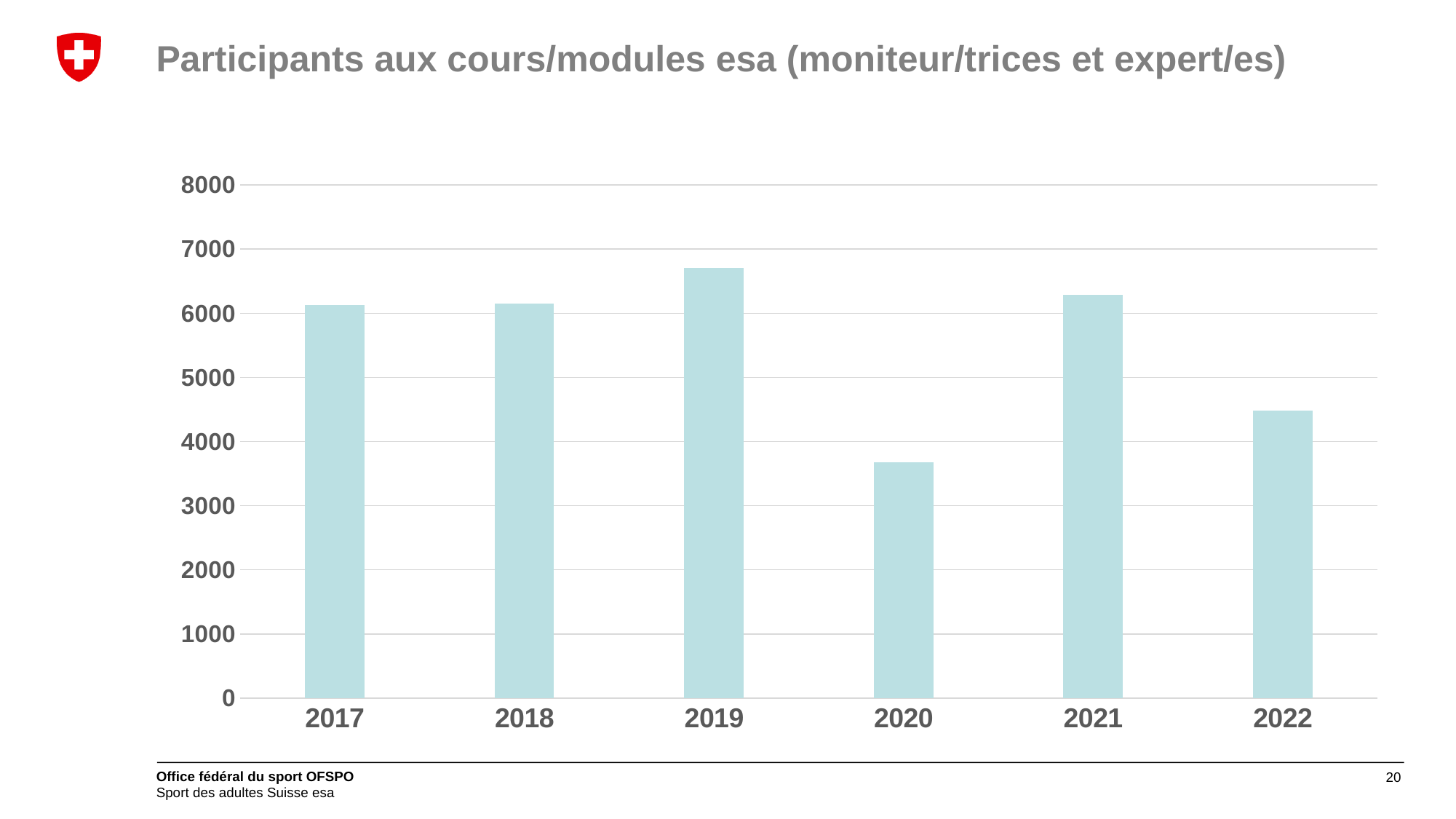
How many years are shown on the x axis of the chart? 6 Which is larger, the value for 2019 or the value for 2021? 2019 Is the value for 2022 greater or less than 5000? less Which year has the lowest number of participants? 2020 Is the value for 2021 greater or less than 7000? less Is the value for 2019 greater or less than 6000? greater What kind of chart is shown on the slide? bar chart Which year has the highest number of participants? 2019 Which is larger, the value for 2020 or the value for 2022? 2022 What is the title of the chart on the slide? Participants aux cours/modules esa (moniteur/trices et expert/es) Do the values rise or fall from 2019 to 2020? fall